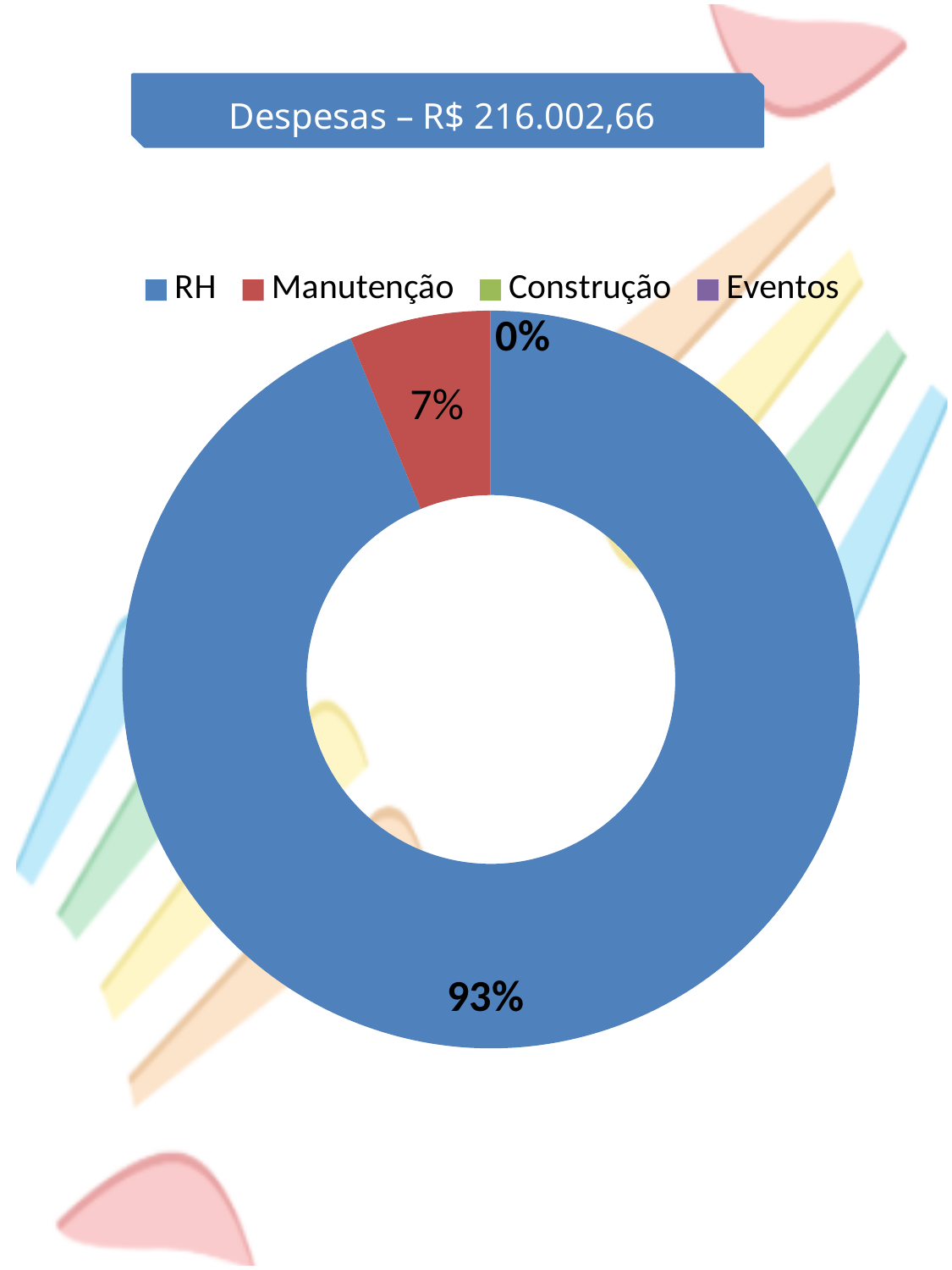
Is the share for RH greater or less than 50%? greater How many categories does the legend list? 4 Which is larger, the RH slice or the Manutenção slice? RH What share of the chart does Manutenção account for? 7% What percentage is shown for the Manutenção slice? 7% What percentage of expenses does the RH slice represent? 93% What colour represents RH in the chart? Blue Which category has the largest share of the chart? RH What is the total expense amount stated in the chart title? R$ 216.002,66 What is the title shown above the chart? Despesas – R$ 216.002,66 What is the difference in percentage points between the RH slice and the Manutenção slice? 86 percentage points What kind of chart is shown on the slide? Doughnut (pie) chart